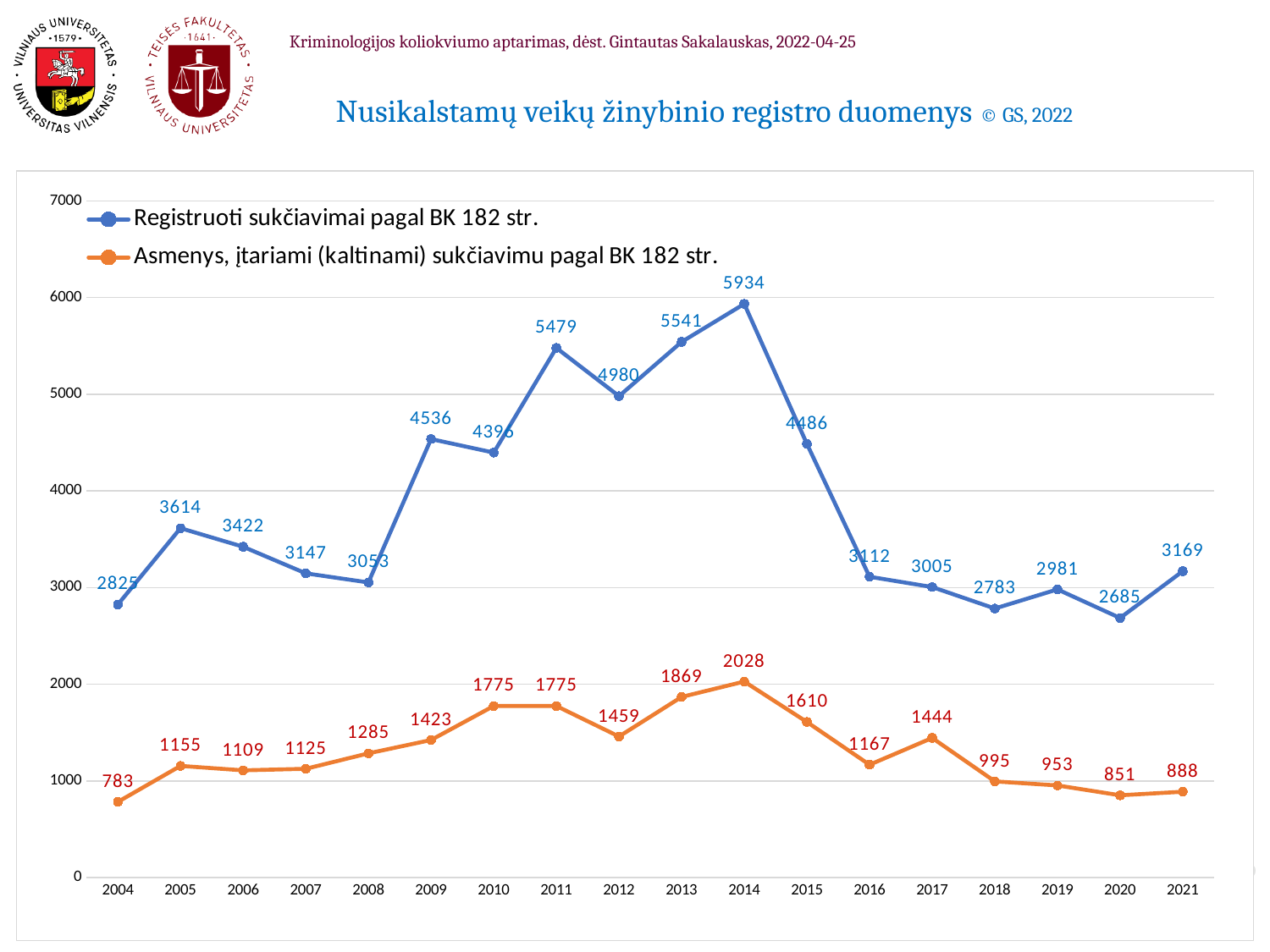
In which year is 'Asmenys, įtariami (kaltinami) sukčiavimu pagal BK 182 str.' lowest? 2004 What type of chart is shown on the slide? Line chart In which year does 'Registruoti sukčiavimai pagal BK 182 str.' reach its highest value? 2014 Is the value of 'Registruoti sukčiavimai pagal BK 182 str.' in 2020 greater or less than 3000? less Which is larger: 'Asmenys, įtariami (kaltinami) sukčiavimu pagal BK 182 str.' in 2013 or in 2017? 2013 What is the value of 'Registruoti sukčiavimai pagal BK 182 str.' in 2014? 5934 How many years are plotted along the x axis? 18 What colour is the line for 'Asmenys, įtariami (kaltinami) sukčiavimu pagal BK 182 str.'? Orange Does 'Registruoti sukčiavimai pagal BK 182 str.' rise or fall from 2014 to 2016? fall How many series does the legend list? 2 What is the value of 'Asmenys, įtariami (kaltinami) sukčiavimu pagal BK 182 str.' in 2004? 783 What is the difference between 'Registruoti sukčiavimai pagal BK 182 str.' in 2014 and in 2015? 1448